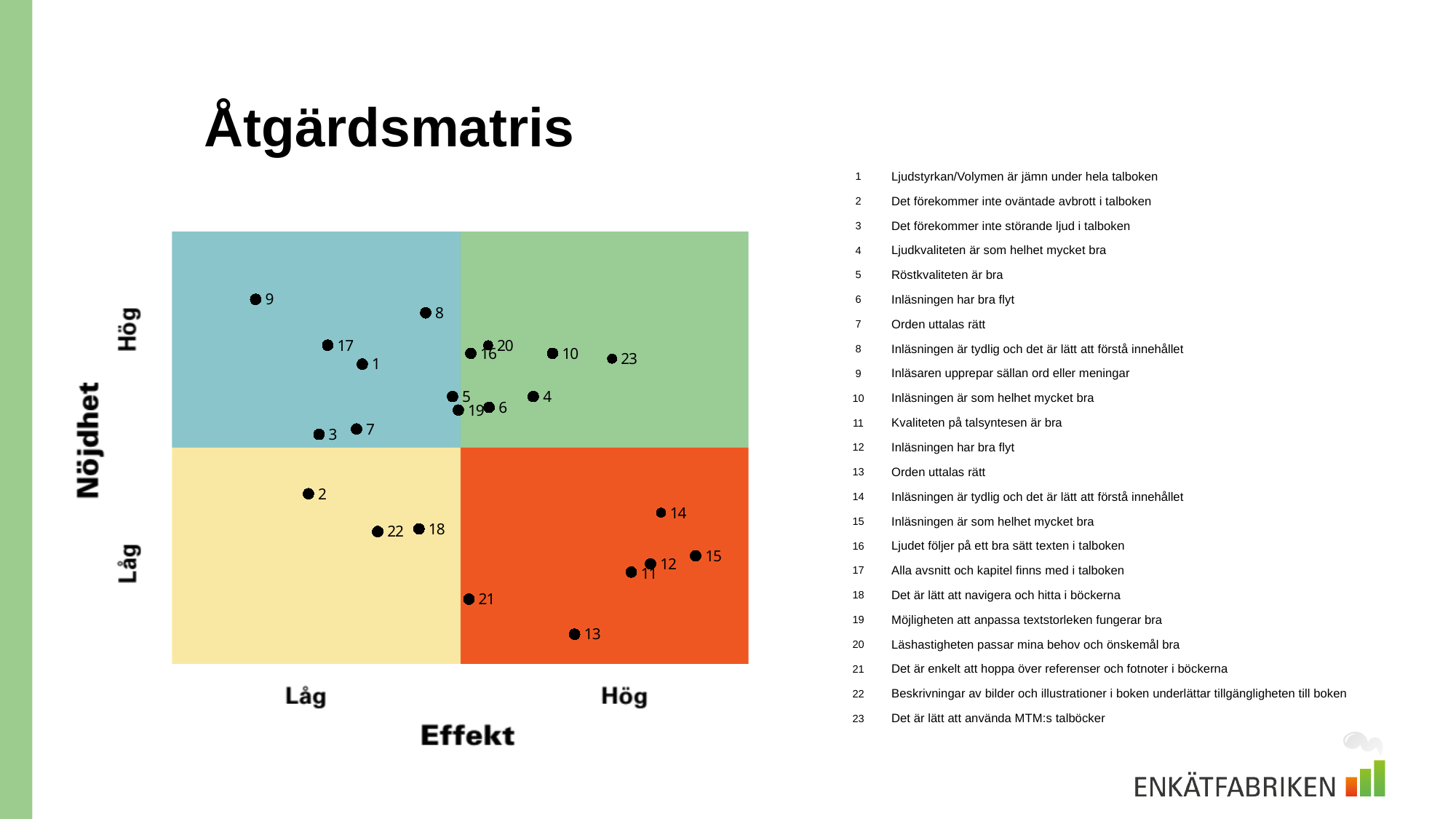
How many points lie in the yellow quadrant (low Effekt, low Nöjdhet)? 3 Which point has higher Effekt, point 15 or point 14? 15 What is the label of the vertical axis of the matrix? Nöjdhet Which numbered point is plotted furthest to the right on the Effekt axis? 15 What kind of chart is shown on the slide? scatter plot How many numbered points are plotted in the matrix? 23 In which quadrant is point 14 plotted? high Effekt, low Nöjdhet (orange) Which numbered point is plotted furthest to the left on the Effekt axis? 9 Which numbered point is plotted lowest on the Nöjdhet axis? 13 What is the label of the horizontal axis of the matrix? Effekt Which point has higher Nöjdhet, point 9 or point 13? 9 Which numbered point is plotted highest on the Nöjdhet axis? 9